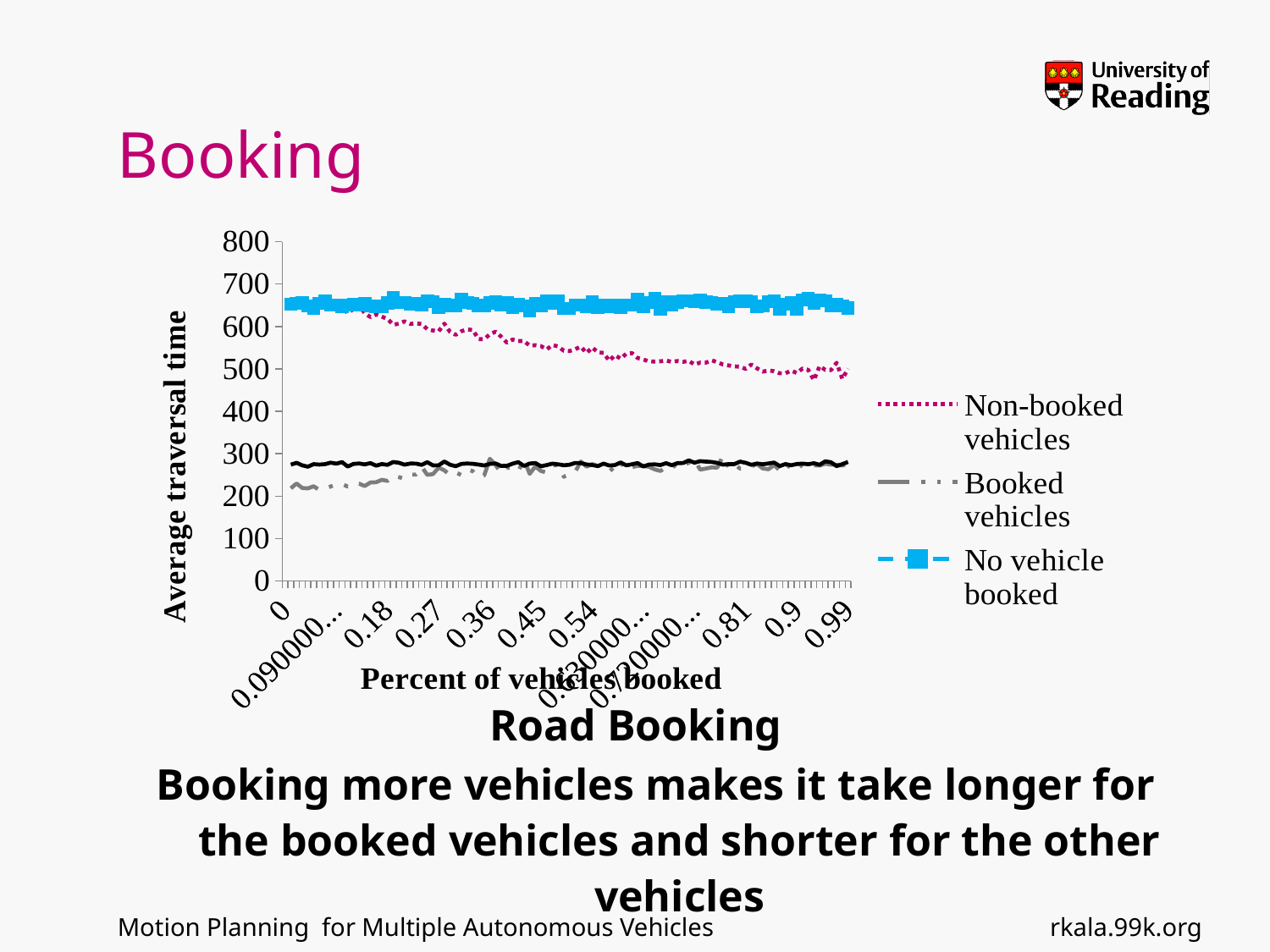
At 0.9 on the x axis, which is larger: Non-booked vehicles or No vehicle booked? No vehicle booked What kind of chart is shown on the slide? line chart Is the value for No vehicle booked at 0.54 greater or less than 600? greater Is the value for Non-booked vehicles at 0.99 greater or less than 600? less Which series has the highest average traversal time across the chart? No vehicle booked What is the title of the vertical axis? Average traversal time Do the values for Booked vehicles rise or fall as the percent of vehicles booked increases? rise How many series does the legend list? 3 Is the value for Booked vehicles at 0 greater or less than 300? less Do the values for Non-booked vehicles rise or fall as the percent of vehicles booked increases? fall What is the title of the horizontal axis? Percent of vehicles booked Which series has the lowest average traversal time across the chart? Booked vehicles